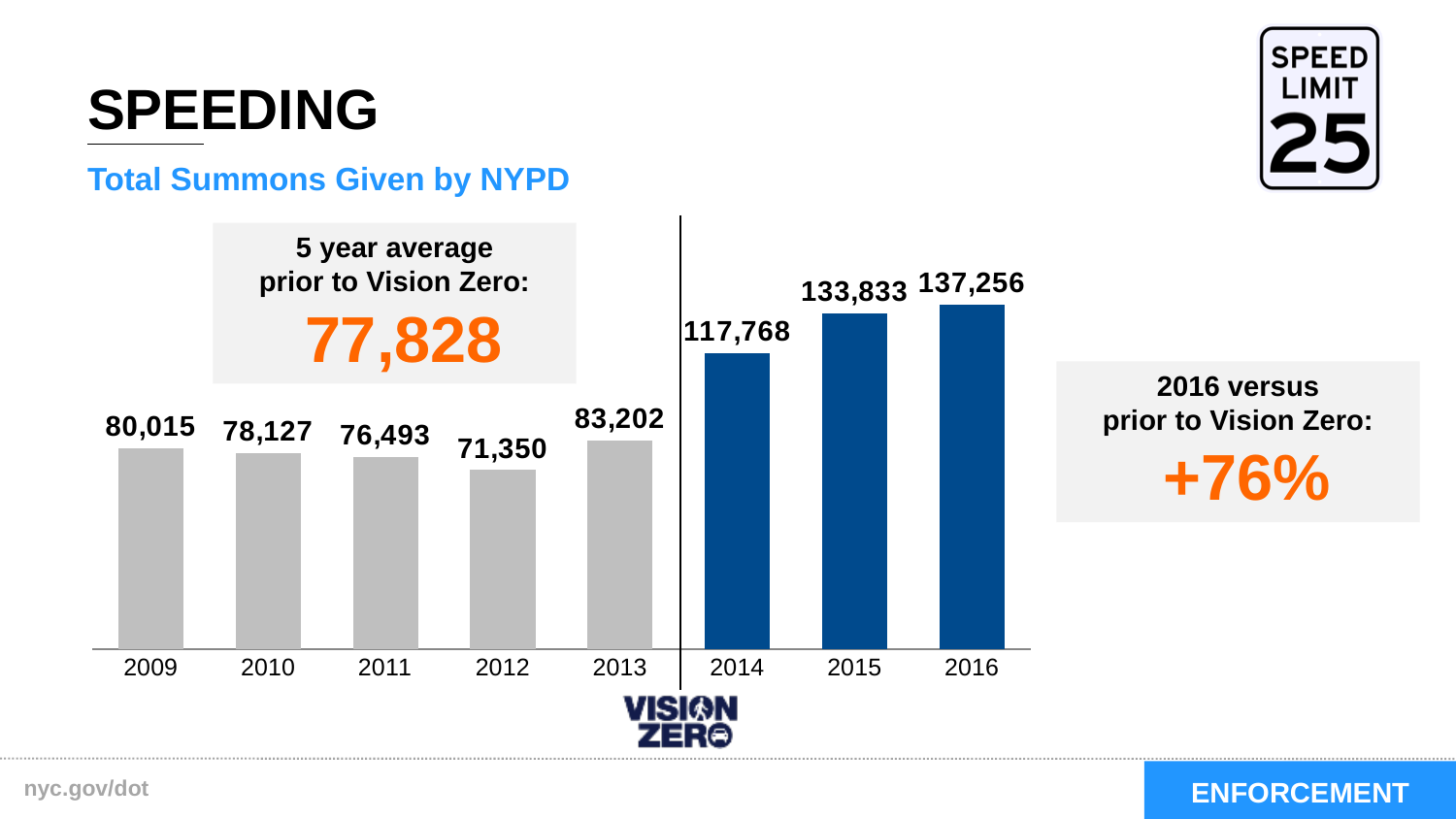
Which year has the lowest number of summons? 2012 What is the 5 year average prior to Vision Zero shown on the slide? 77,828 What is the difference between the 2014 and 2013 values? 34,566 Do the values rise or fall from 2013 to 2016? Rise Which is larger, the value for 2009 or the value for 2013? 2013 Which year has the highest number of summons? 2016 How many years are shown on the x axis of the chart? 8 What is the difference between the 2016 and 2015 values? 3,423 What is the value shown for 2012? 71,350 What is the value shown for 2009? 80,015 What kind of chart is shown on the slide? Bar chart What is the total number of summons given by NYPD in 2014? 117,768